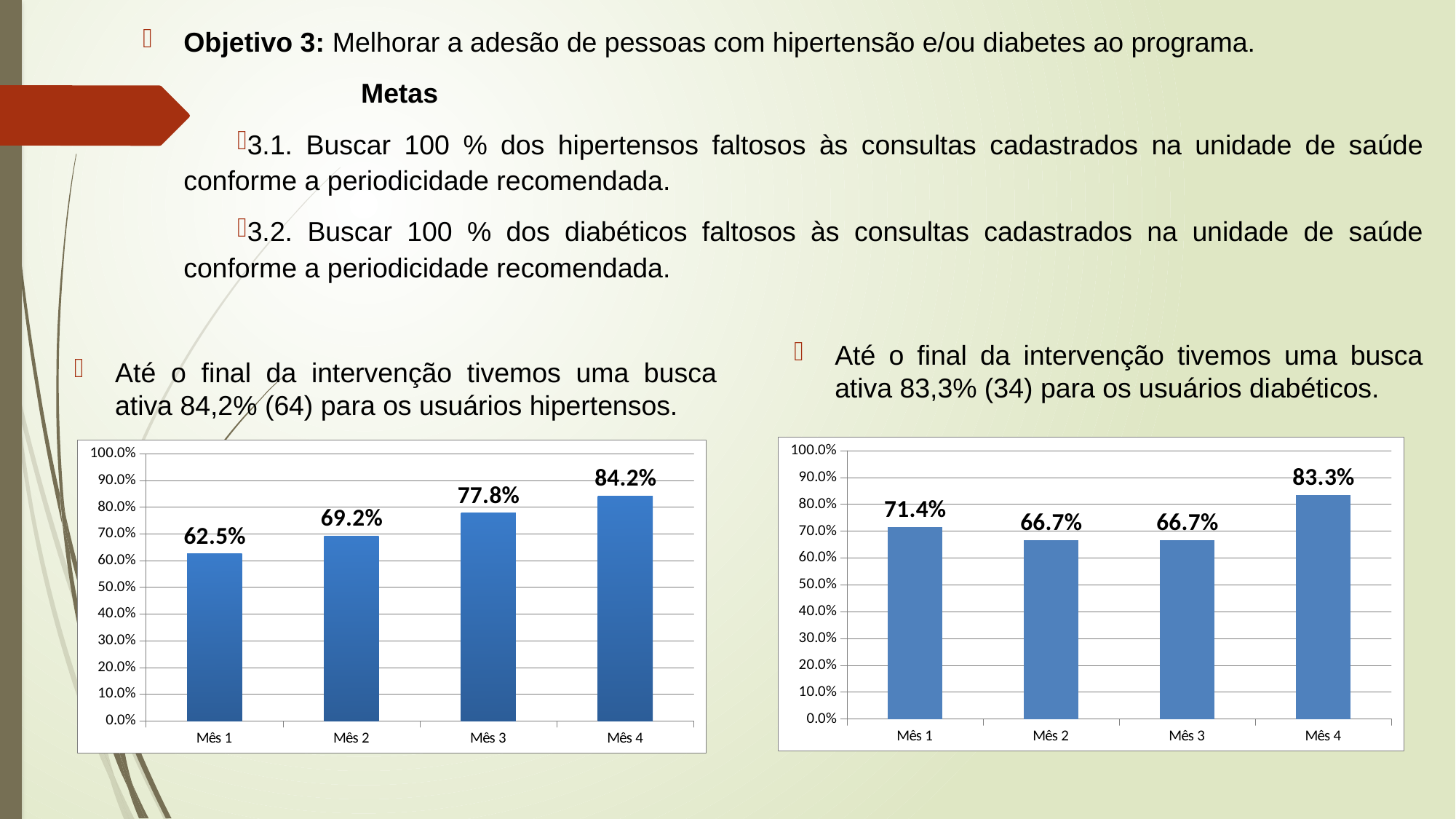
In the right chart (diabetic users), which month has the highest value? Mês 4 In the left chart (hypertensive users), what is the value for Mês 3? 77.8% In the left chart (hypertensive users), which month has the lowest value? Mês 1 In the right chart (diabetic users), what is the value for Mês 4? 83.3% In the left chart (hypertensive users), what is the value for Mês 1? 62.5% In the right chart (diabetic users), what is the value for Mês 1? 71.4% What kind of chart is the right chart (diabetic users)? Bar chart In the left chart (hypertensive users), which month has the highest value? Mês 4 In the right chart (diabetic users), which is larger, Mês 1 or Mês 3? Mês 1 How many months are shown on the x axis of the left chart (hypertensive users)? 4 In the left chart (hypertensive users), what is the difference between Mês 4 and Mês 1? 21.7% In the right chart (diabetic users), what is the difference between Mês 4 and Mês 2? 16.6%